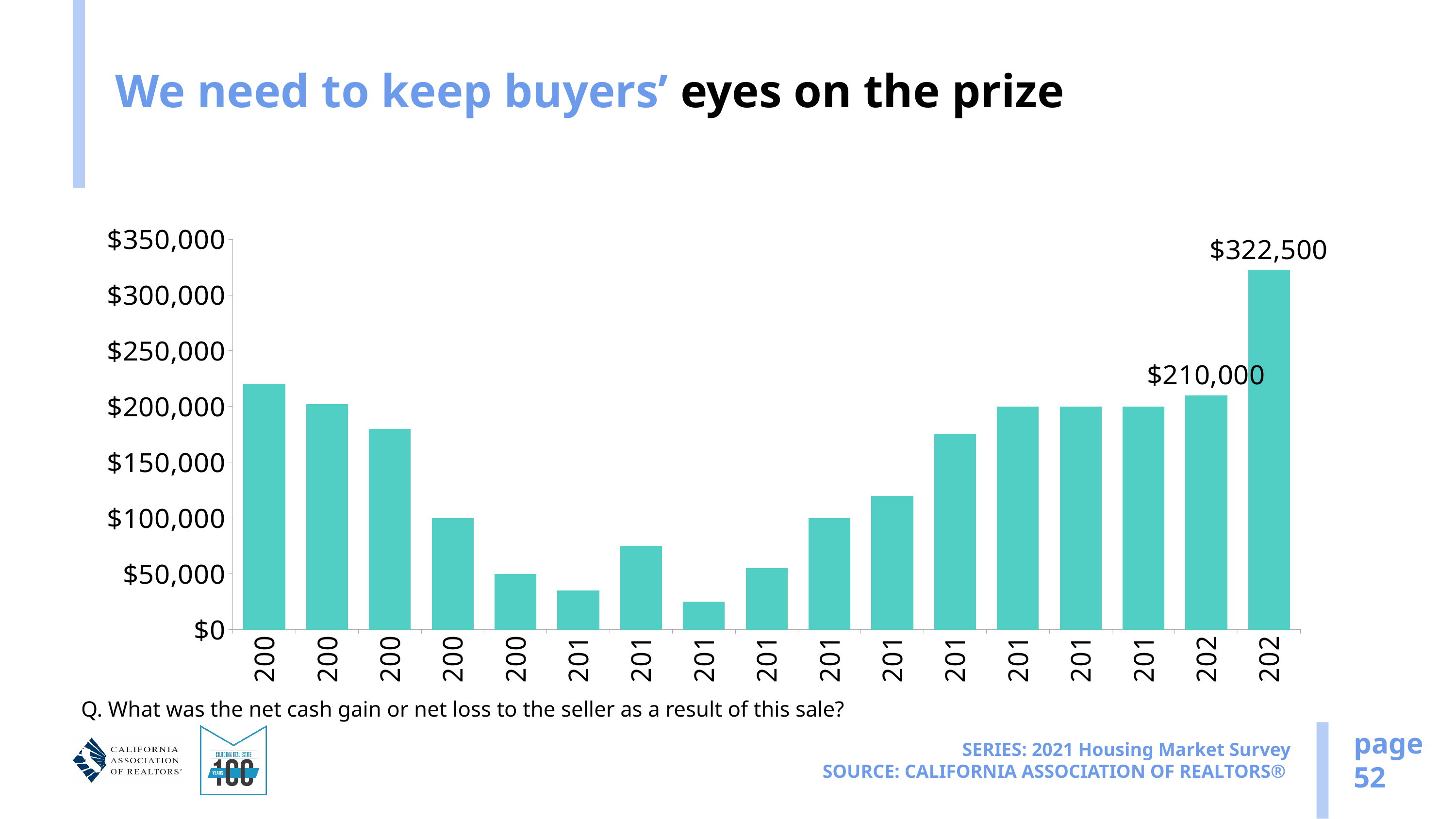
Which bar is the tallest in the chart? The rightmost (last) bar Is the value of the first (leftmost) bar greater or less than $200,000? greater What kind of chart is shown on the slide? Bar chart Which is larger, the first bar on the left or the second bar from the left? The first bar on the left What is the difference between the two labelled values, $322,500 and $210,000? $112,500 What is the value shown on the data label of the second bar from the right? $210,000 What is the value shown on the data label of the rightmost bar? $322,500 Which bar is the shortest in the chart? The eighth bar from the left What survey question is printed below the chart? Q. What was the net cash gain or net loss to the seller as a result of this sale? Is the value of the sixth bar from the left greater or less than $50,000? less From the eighth bar to the rightmost bar, do the values generally rise or fall? Rise How many bars are plotted in the chart? 17